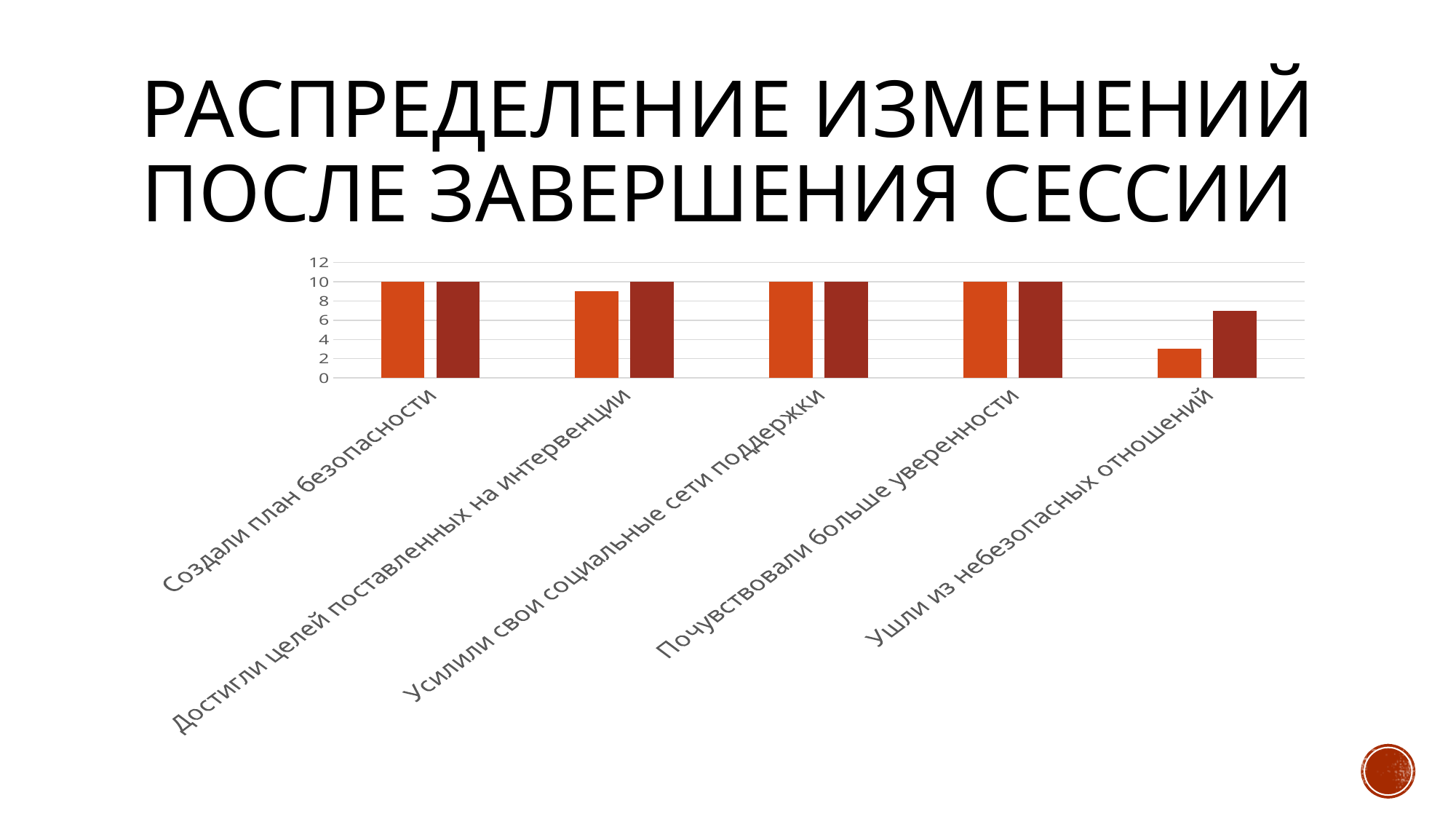
What is the value of the orange bar for "Почувствовали больше уверенности"? 10 What kind of chart is shown on the slide? bar chart How many categories are shown on the x axis of the chart? 5 For "Ушли из небезопасных отношений", which bar is larger, the orange one or the dark red one? the dark red one What is the highest value shown on the vertical axis of the chart? 12 What is the value of the orange bar for "Создали план безопасности"? 10 What is the value of the dark red bar for "Достигли целей поставленных на интервенции"? 10 Is the orange bar for "Достигли целей поставленных на интервенции" greater or less than 8? greater Is the orange bar for "Ушли из небезопасных отношений" greater or less than 4? less Is the dark red bar for "Ушли из небезопасных отношений" greater or less than 6? greater Which category has the lowest orange bar? Ушли из небезопасных отношений Which is larger: the orange bar for "Усилили свои социальные сети поддержки" or the orange bar for "Ушли из небезопасных отношений"? Усилили свои социальные сети поддержки